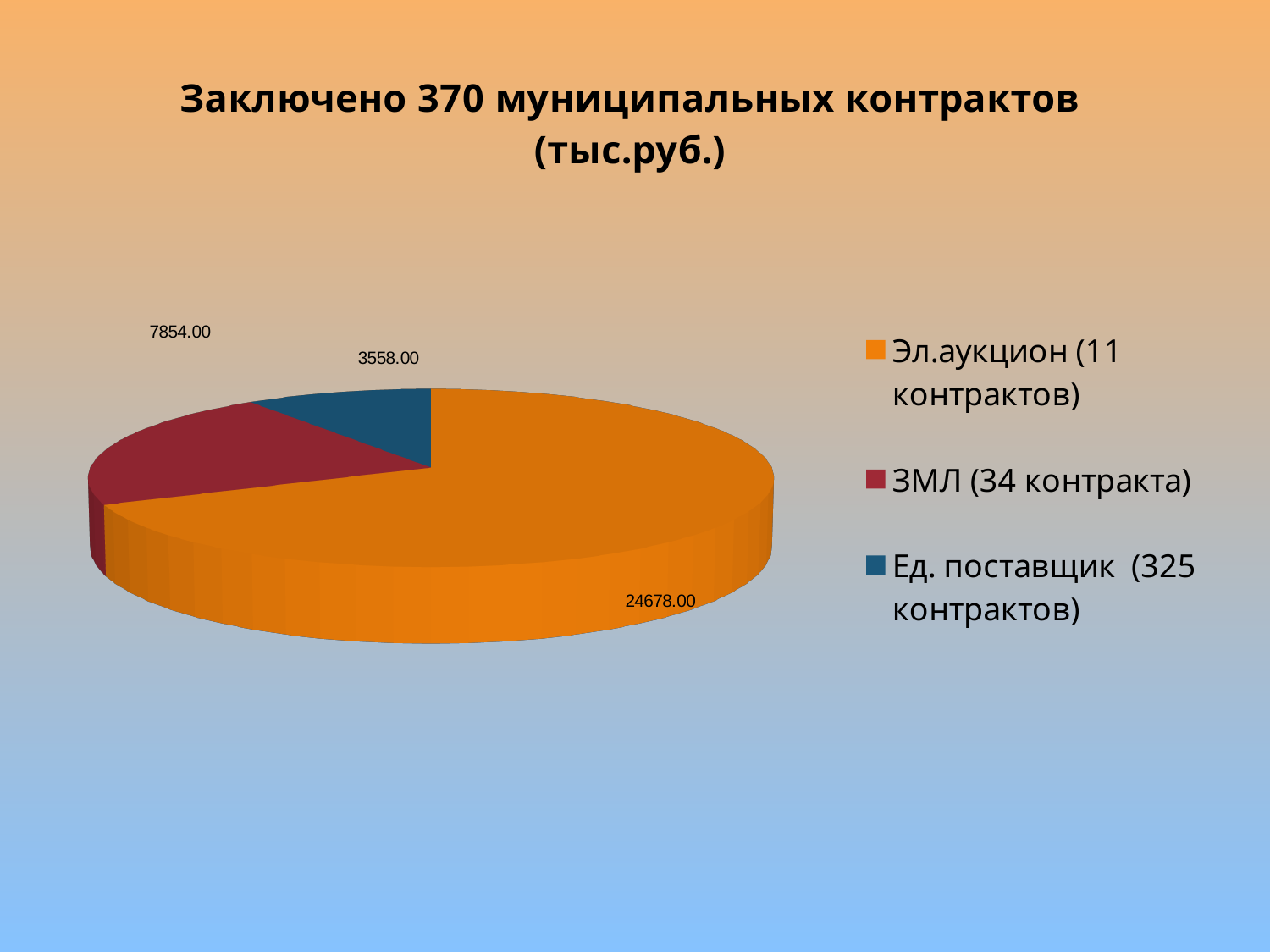
How many slices does the pie chart have? 3 What is the title of the chart? Заключено 370 муниципальных контрактов (тыс.руб.) What is the difference between the values for ЗМЛ (34 контракта) and Ед. поставщик (325 контрактов)? 4296.00 What is the value for Ед. поставщик (325 контрактов)? 3558.00 What is the value for ЗМЛ (34 контракта)? 7854.00 What kind of chart is shown on the slide? Pie chart Which is larger, the value for ЗМЛ (34 контракта) or the value for Ед. поставщик (325 контрактов)? ЗМЛ (34 контракта) What is the total of all three slices of the pie? 36090.00 What is the value for Эл.аукцион (11 контрактов)? 24678.00 Which category has the largest slice of the pie? Эл.аукцион (11 контрактов) What is the difference between the values for Эл.аукцион (11 контрактов) and ЗМЛ (34 контракта)? 16824.00 Which category has the smallest slice of the pie? Ед. поставщик (325 контрактов)